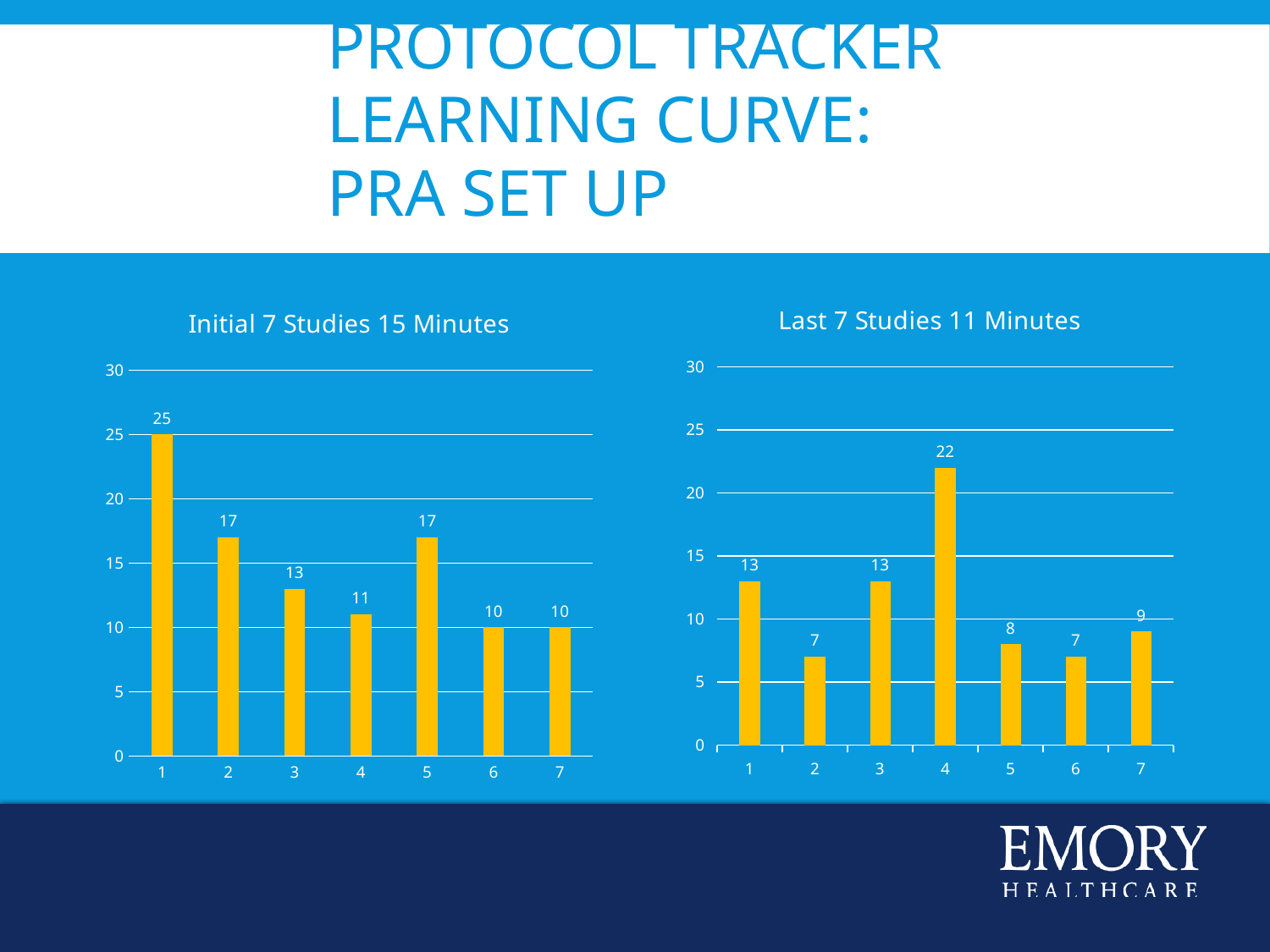
In the 'Last 7 Studies 11 Minutes' chart, what is the value for study 4? 22 In the 'Last 7 Studies 11 Minutes' chart, which is larger, the value for study 5 or study 7? study 7 In the 'Last 7 Studies 11 Minutes' chart, which study has the highest value? 4 What kind of chart is the 'Initial 7 Studies 15 Minutes' chart? bar chart In the 'Last 7 Studies 11 Minutes' chart, what is the difference between the values for study 4 and study 1? 9 In the 'Initial 7 Studies 15 Minutes' chart, what is the value for study 4? 11 In the 'Initial 7 Studies 15 Minutes' chart, is the value for study 3 greater or less than 10? greater In the 'Initial 7 Studies 15 Minutes' chart, which study has the highest value? 1 What is the title of the chart on the right side of the slide? Last 7 Studies 11 Minutes In the 'Initial 7 Studies 15 Minutes' chart, what is the value for study 1? 25 In the 'Initial 7 Studies 15 Minutes' chart, what is the difference between the values for study 1 and study 2? 8 How many studies are plotted in the 'Last 7 Studies 11 Minutes' chart? 7